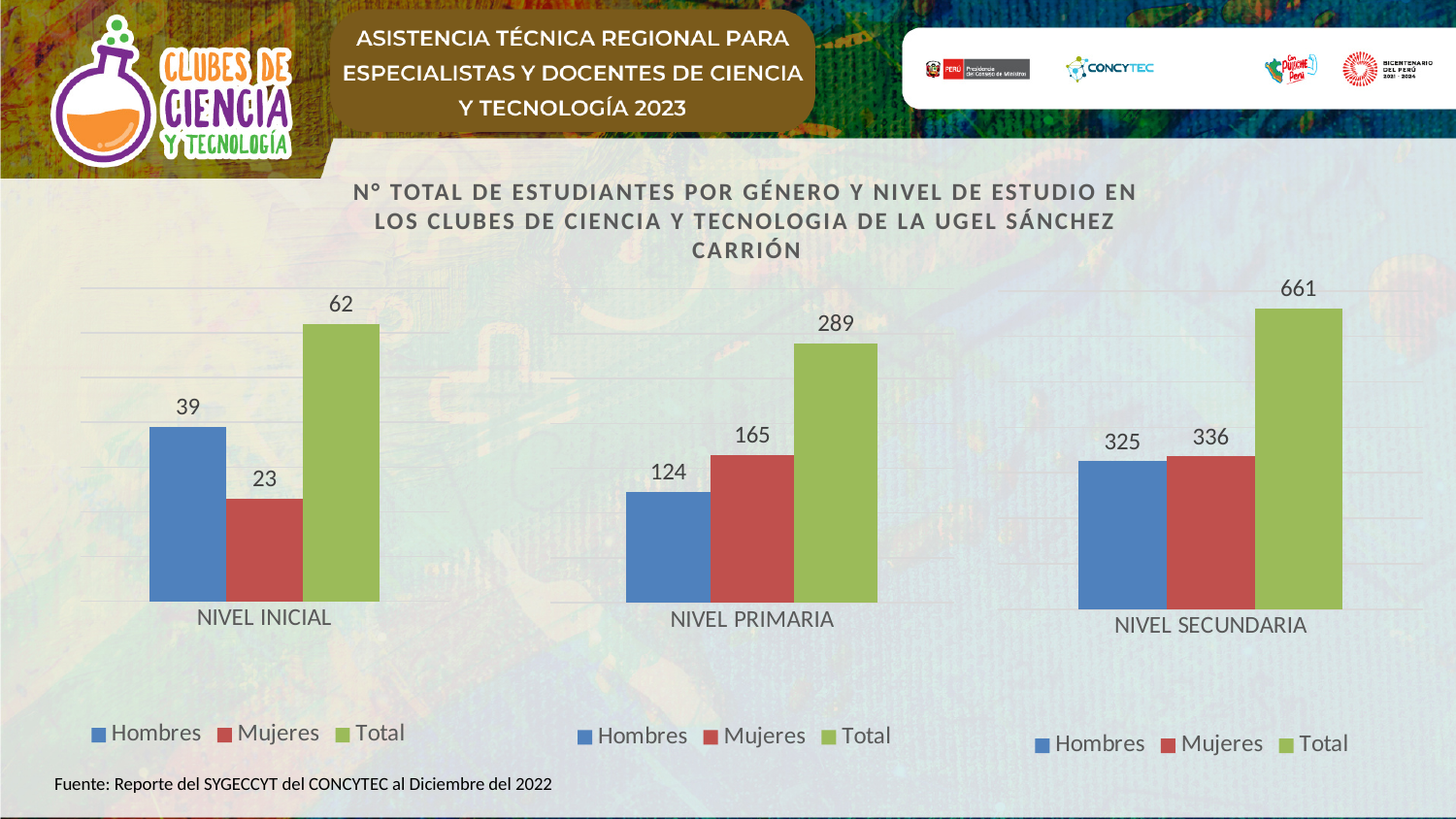
In the NIVEL PRIMARIA chart (middle), what is the value for Total? 289 In the NIVEL SECUNDARIA chart (right), which series has the highest value? Total In the NIVEL INICIAL chart (left), which is larger, Hombres or Mujeres? Hombres In the NIVEL INICIAL chart (left), what is the value for Hombres? 39 What colour are the Total bars in the three charts? Green In the NIVEL SECUNDARIA chart (right), what is the difference between Mujeres and Hombres? 11 What kind of chart is the NIVEL SECUNDARIA chart (right)? Bar chart In the NIVEL PRIMARIA chart (middle), which series has the lowest value? Hombres In the NIVEL INICIAL chart (left), what is the value for Mujeres? 23 In the NIVEL PRIMARIA chart (middle), what is the difference between Mujeres and Hombres? 41 In the NIVEL SECUNDARIA chart (right), what is the value for Mujeres? 336 How many series does the legend of the NIVEL PRIMARIA chart (middle) list? 3